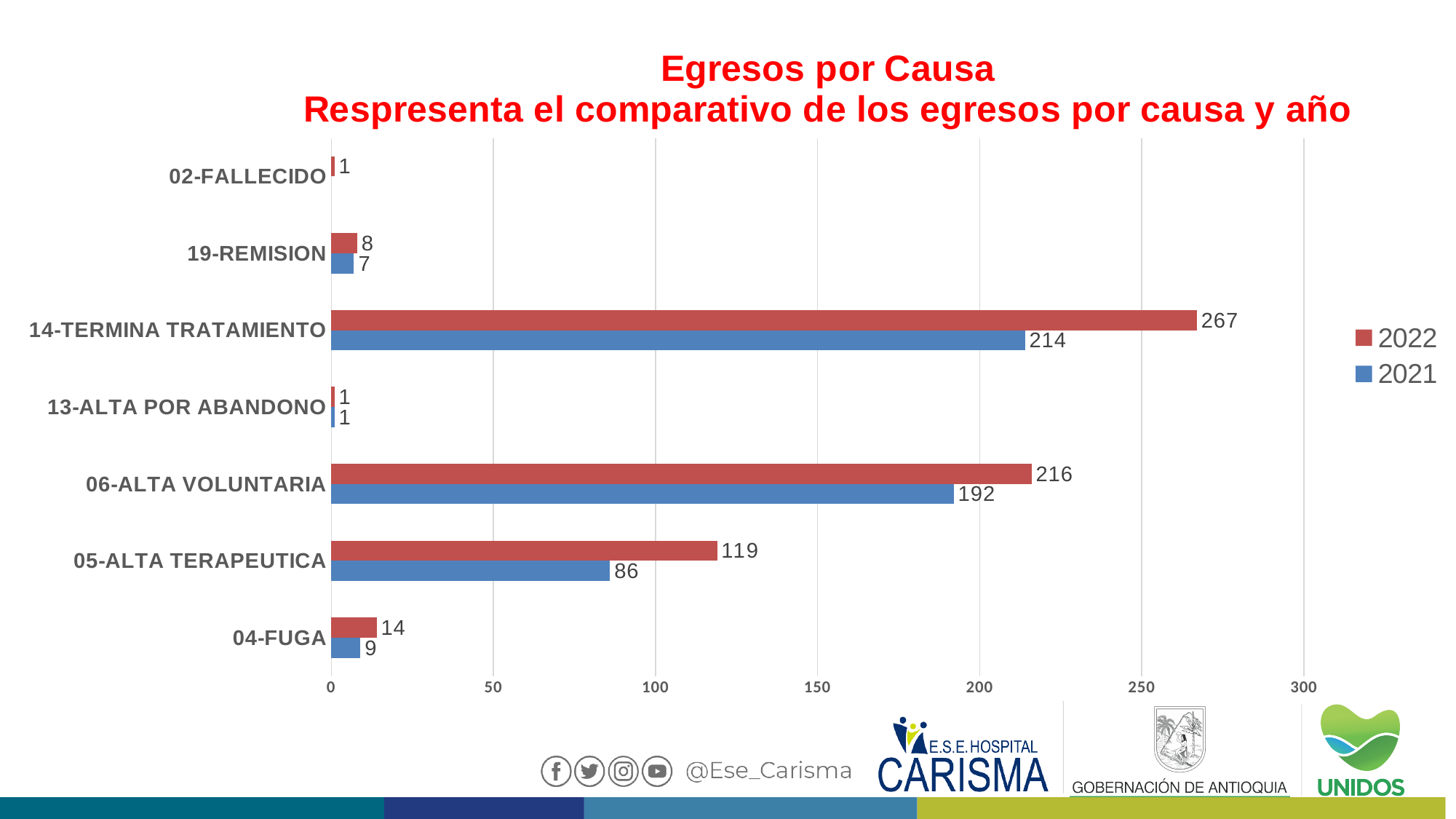
How many categories are shown on the chart? 7 What is the 2021 value for 04-FUGA? 9 What kind of chart is shown on the slide? Bar chart What is the 2021 value for 05-ALTA TERAPEUTICA? 86 Which category has the highest 2021 value? 14-TERMINA TRATAMIENTO What is the 2022 value for 14-TERMINA TRATAMIENTO? 267 Which is larger, the 2022 value for 05-ALTA TERAPEUTICA or the 2021 value for 06-ALTA VOLUNTARIA? 2021 value for 06-ALTA VOLUNTARIA Which colour represents the 2021 series in the legend? Blue How many series does the legend list? 2 What is the difference between the 2022 and 2021 values for 06-ALTA VOLUNTARIA? 24 What is the difference between the 2022 and 2021 values for 14-TERMINA TRATAMIENTO? 53